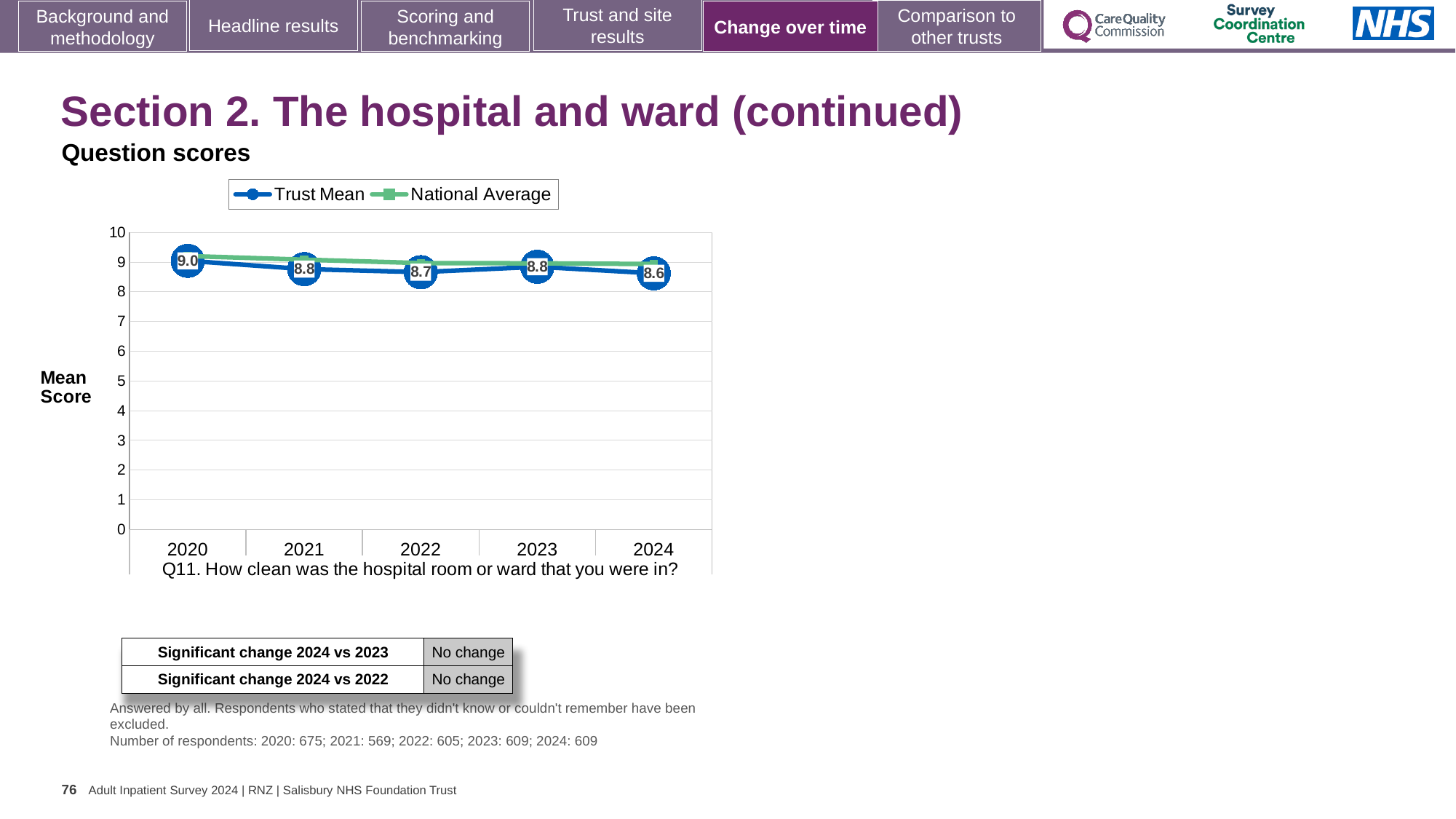
What is the difference between the Trust Mean in 2020 and in 2024? 0.4 What kind of chart is shown? Line chart What is the Trust Mean value for 2024? 8.6 What is the Trust Mean value for 2020? 9.0 How many series does the legend list? 2 In which year is the Trust Mean lowest? 2024 What is the Trust Mean value for 2022? 8.7 Which is larger, the Trust Mean for 2021 or for 2022? 2021 How many years are plotted on the x axis? 5 Is the National Average value for 2024 greater or less than 8? greater Does the Trust Mean overall rise or fall from 2020 to 2024? Fall In which year is the Trust Mean highest? 2020